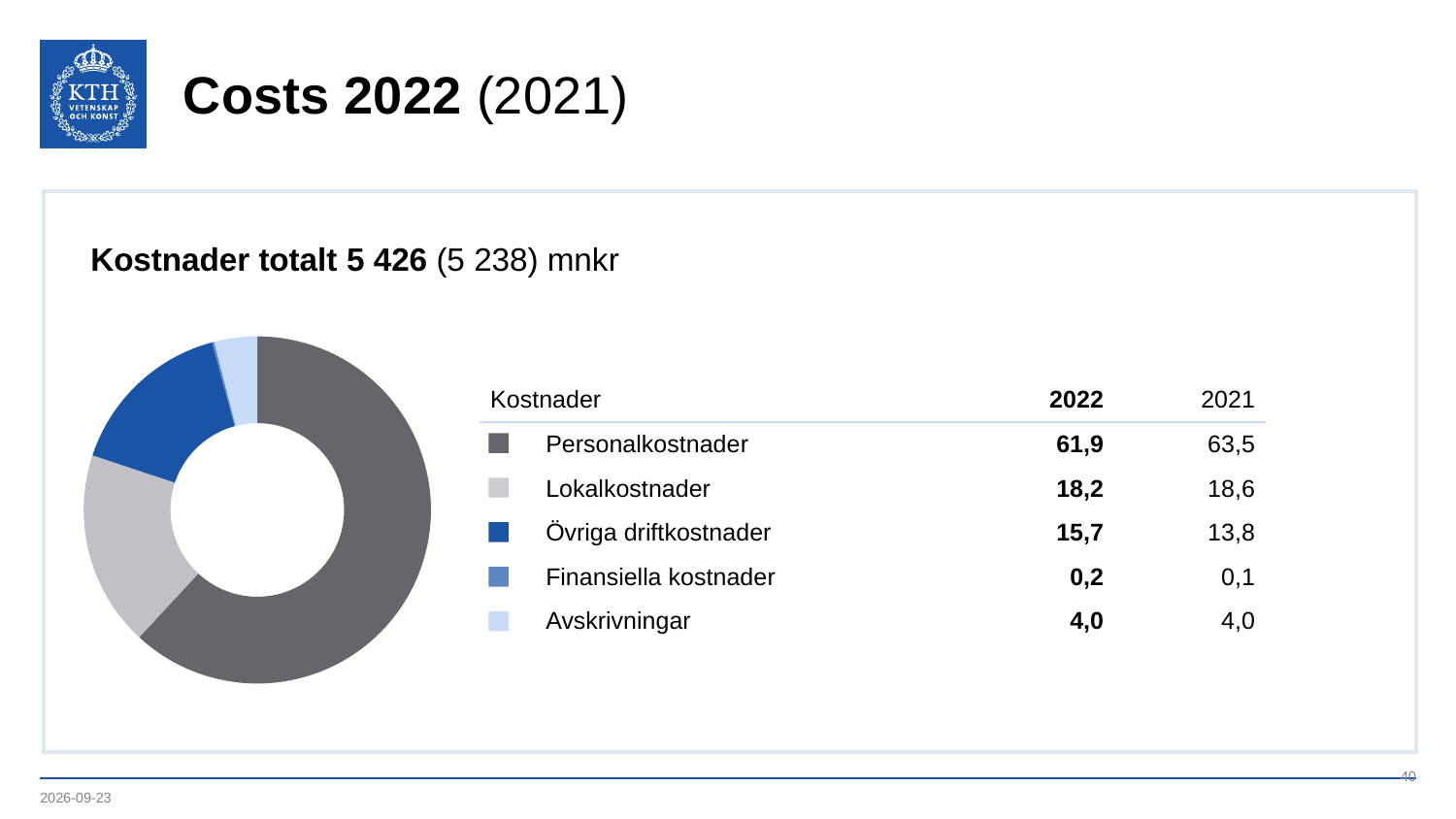
What is the 2022 value for Avskrivningar? 4,0 What kind of chart is shown on the slide? Pie chart (donut) What is the difference between the 2021 and 2022 values for Personalkostnader? 1,6 How many cost categories are listed in the chart's legend? 5 Which cost category has the highest value in 2022? Personalkostnader Which cost category has the lowest value in 2022? Finansiella kostnader What is the 2022 value for Personalkostnader? 61,9 Which year has the larger value for Övriga driftkostnader, 2022 or 2021? 2022 What is the difference between the 2022 values for Personalkostnader and Lokalkostnader? 43,7 What is the 2021 value for Övriga driftkostnader? 13,8 What total cost for 2022 is stated above the chart? 5 426 mnkr Which is larger in 2022, Lokalkostnader or Övriga driftkostnader? Lokalkostnader